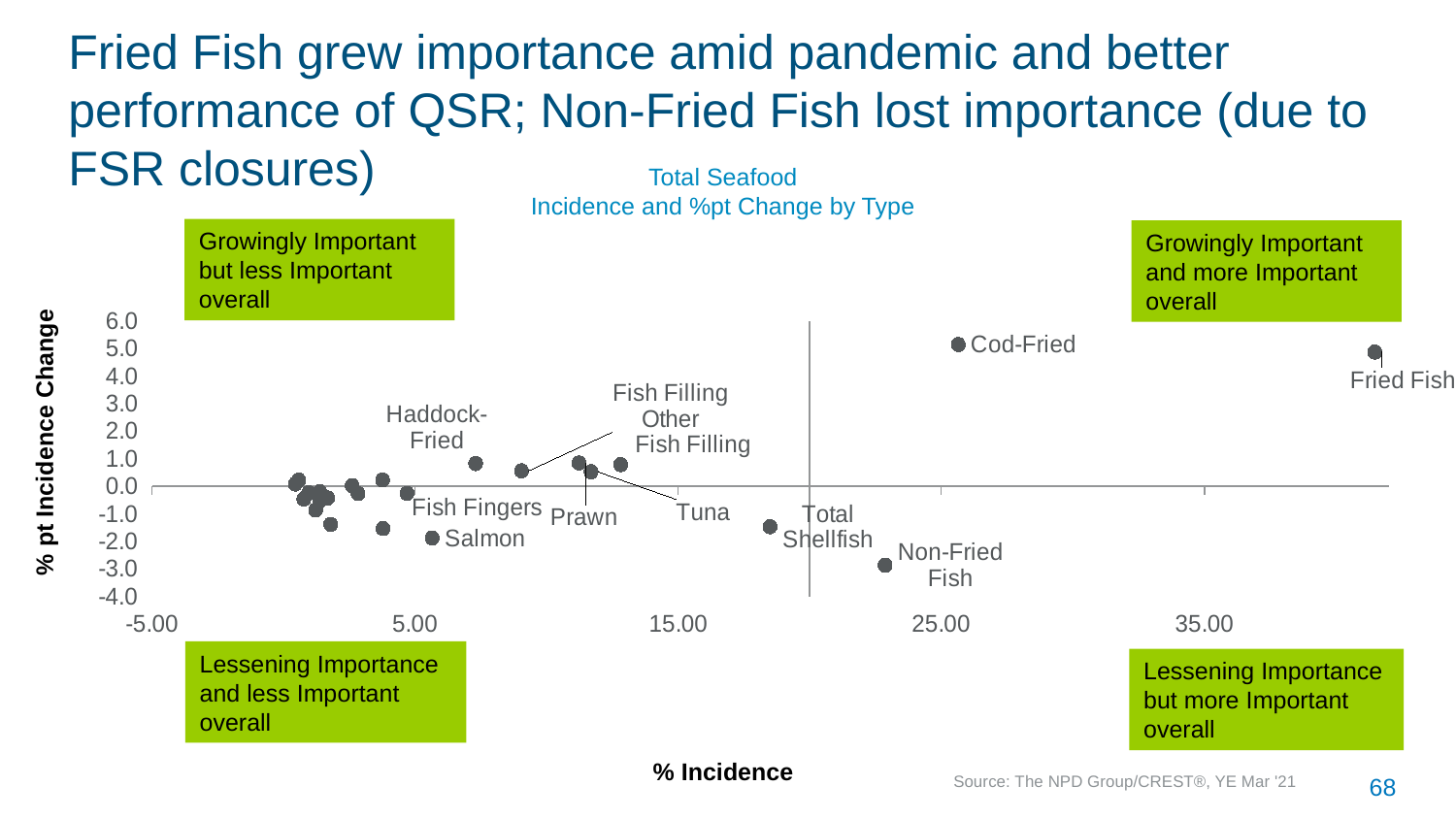
Which seafood type has the highest % Incidence? Fried Fish What kind of chart is shown on the slide? Scatter chart Is the % pt Incidence Change for Non-Fried Fish greater or less than -2.0? less Which seafood type has the lowest % pt Incidence Change? Non-Fried Fish Is the % pt Incidence Change for Salmon greater or less than -1.0? less What is the title of the chart? Total Seafood Incidence and %pt Change by Type Which has the higher % pt Incidence Change, Cod-Fried or Non-Fried Fish? Cod-Fried Is the % pt Incidence Change for Cod-Fried greater or less than 4.0? greater Which has the higher % Incidence, Fried Fish or Cod-Fried? Fried Fish What is the label of the vertical axis? % pt Incidence Change